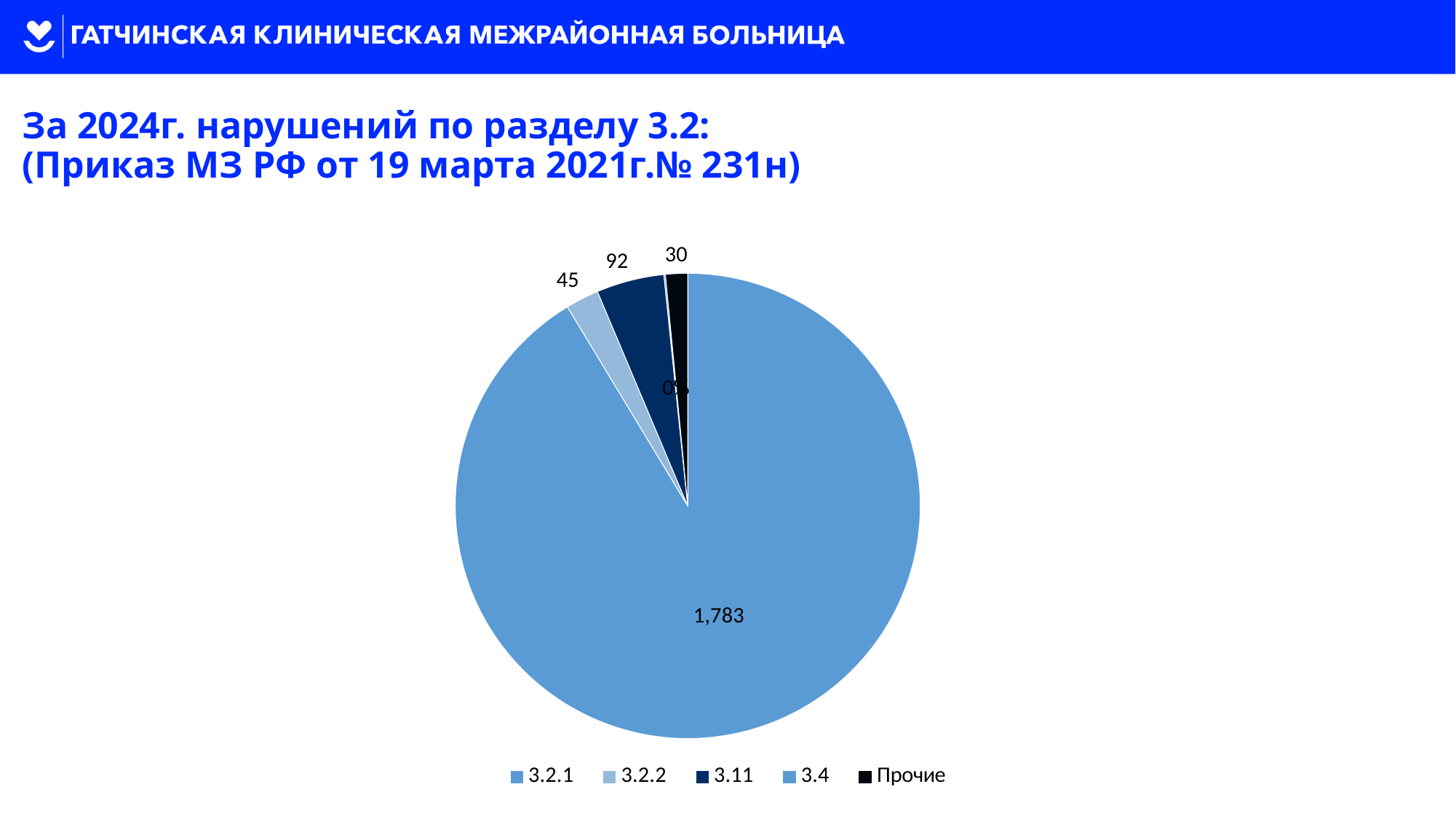
What is the value shown for the category Прочие in the pie chart? 30 What is the difference between the values for 3.11 and 3.2.2? 47 Which category has the smallest slice of the pie chart? 3.4 What is the value shown for category 3.2.1 in the pie chart? 1,783 What kind of chart is shown on the slide? pie chart What is the difference between the values for 3.2.2 and Прочие? 15 What colour is used for the category Прочие in the pie chart? black Which category has the largest slice of the pie chart? 3.2.1 Which category has the larger value, 3.11 or 3.2.2? 3.11 What is the value shown for category 3.2.2 in the pie chart? 45 What is the value shown for category 3.11 in the pie chart? 92 How many categories does the legend of the pie chart list? 5